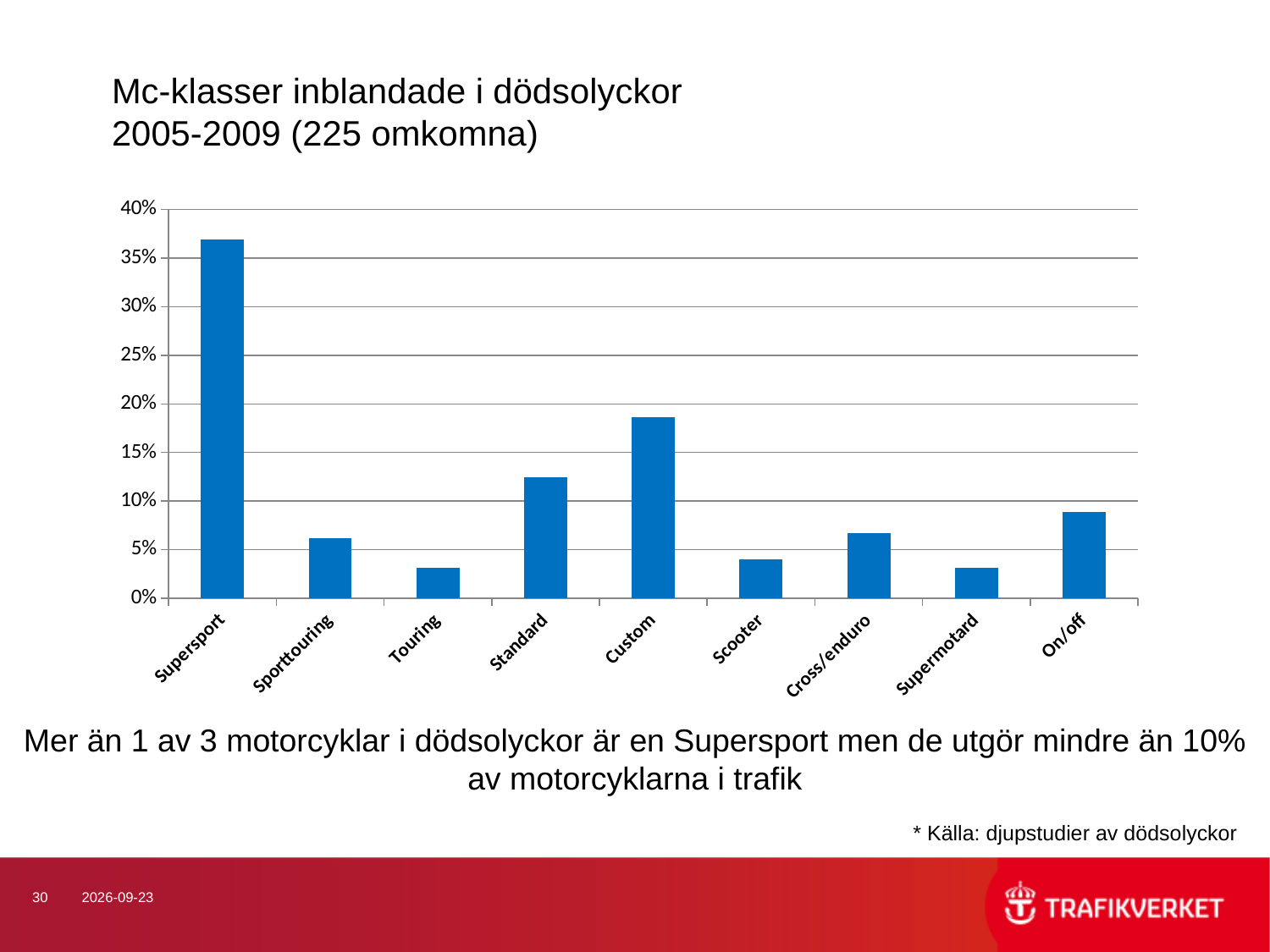
Is the value for Custom greater or less than 15%? greater What kind of chart is shown on the slide? bar chart Is the value for On/off greater or less than 10%? less How many motorcycle classes are shown on the x axis of the chart? 9 Is the value for Supersport greater or less than 35%? greater What is the highest value shown on the y axis of the chart? 40% Which motorcycle class has the highest share of fatal accidents in the chart? Supersport Which has a larger value, Scooter or Cross/enduro? Cross/enduro What is the title of the slide containing the chart? Mc-klasser inblandade i dödsolyckor 2005-2009 (225 omkomna) Which has a larger value, Custom or Standard? Custom